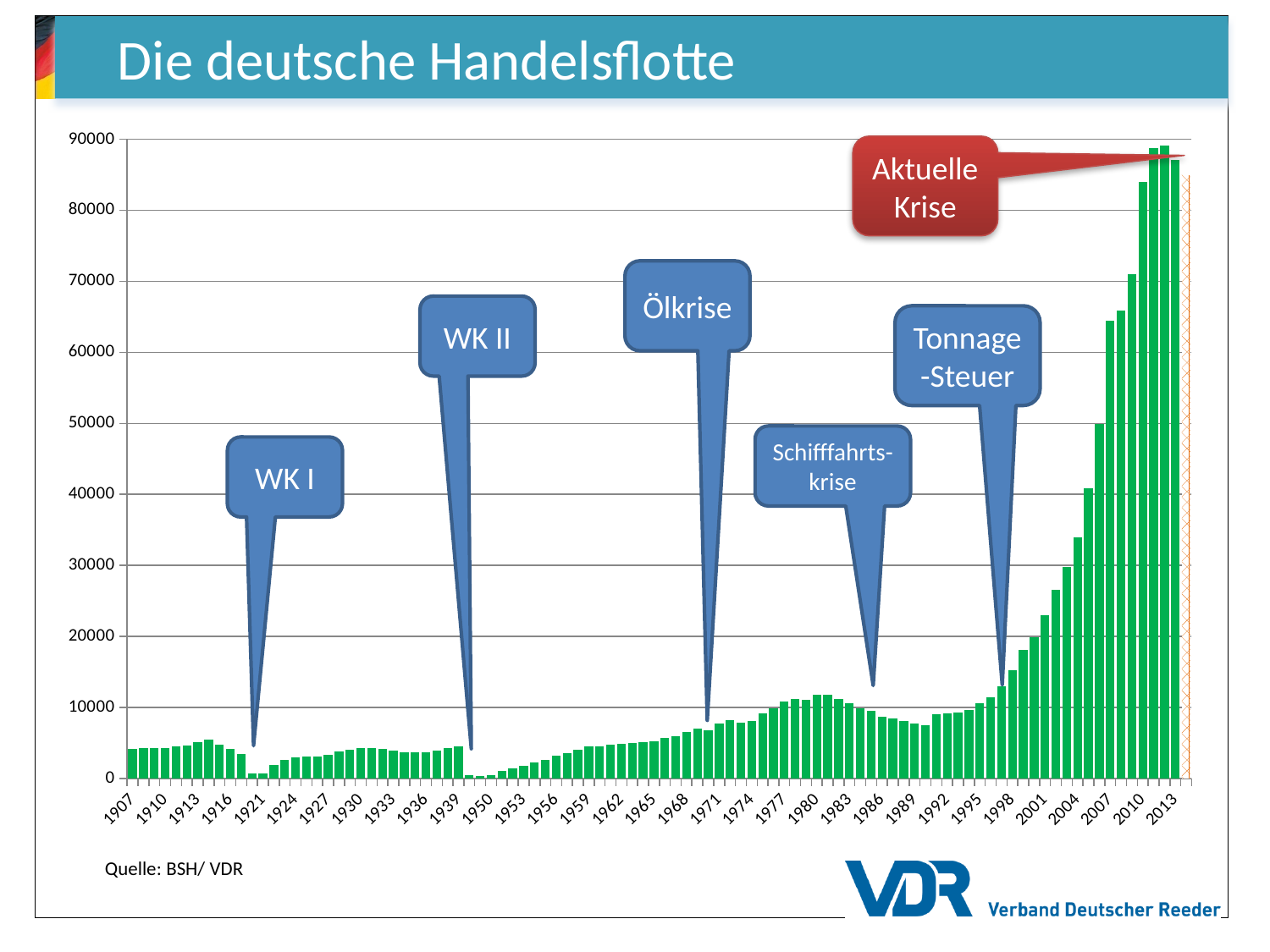
Is the value for 1907 greater or less than 10000? less Do the values rise or fall from 1980 to 1989? fall What is the title of the chart on the slide? Die deutsche Handelsflotte Is the value for 1950 greater or less than 10000? less Is the value for 1998 greater or less than 20000? less Do the values rise or fall from 1995 to 2013? rise What kind of chart is shown on the slide? bar chart Which is larger, the value for 2013 or the value for 1907? 2013 What source is cited below the chart? Quelle: BSH/ VDR